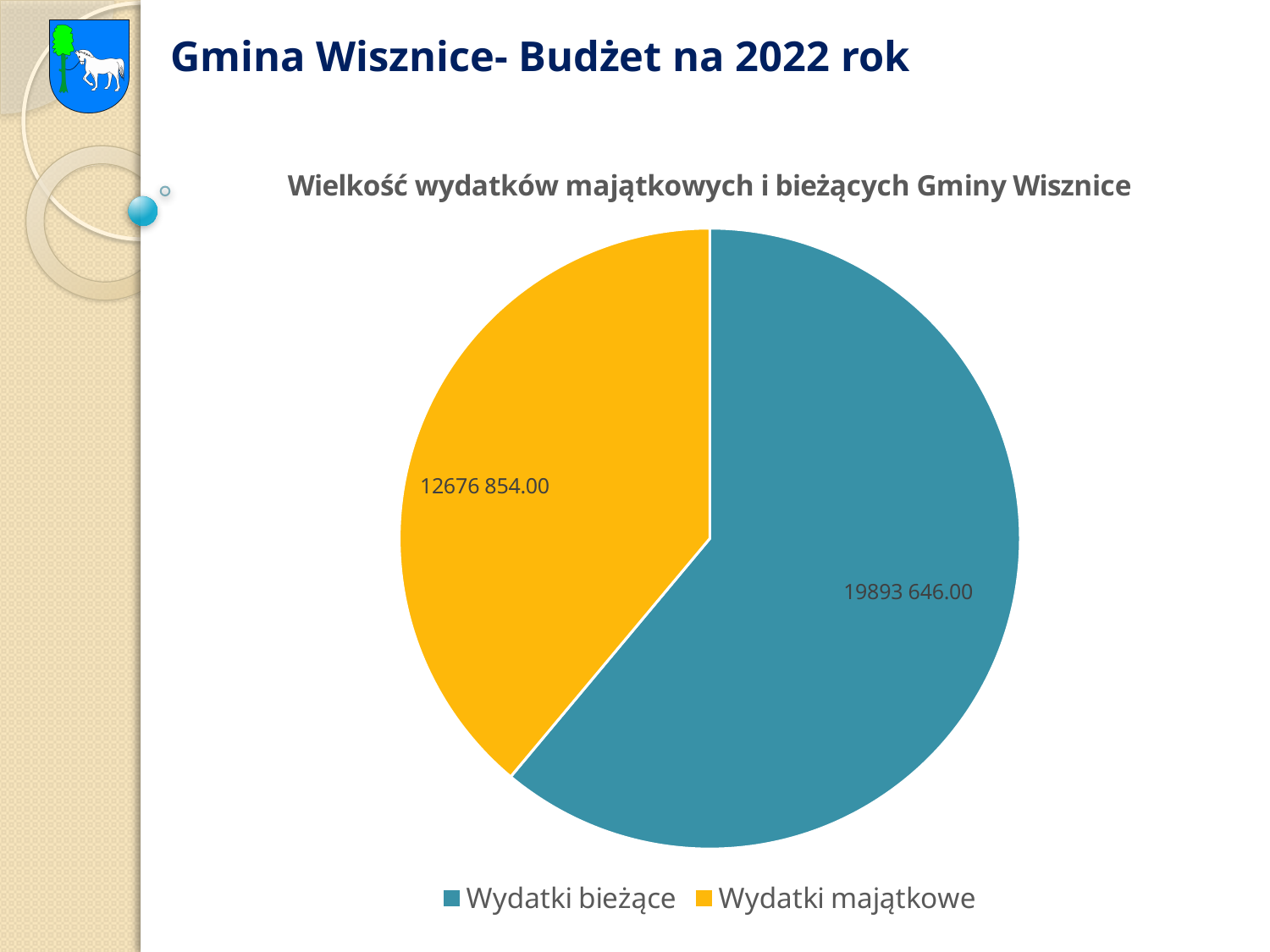
How many slices does the pie chart have? 2 What type of chart is shown on the slide? pie chart What is the value for Wydatki bieżące? 19893 646.00 Which is larger, Wydatki bieżące or Wydatki majątkowe? Wydatki bieżące Which category has the largest slice of the pie? Wydatki bieżące What is the total of the two slices in the pie? 32570 500.00 What colour is the slice for Wydatki majątkowe? yellow How many entries does the legend list? 2 Which category has the smallest slice of the pie? Wydatki majątkowe What is the title of the chart? Wielkość wydatków majątkowych i bieżących Gminy Wisznice What is the value for Wydatki majątkowe? 12676 854.00 What is the difference between Wydatki bieżące and Wydatki majątkowe? 7216 792.00